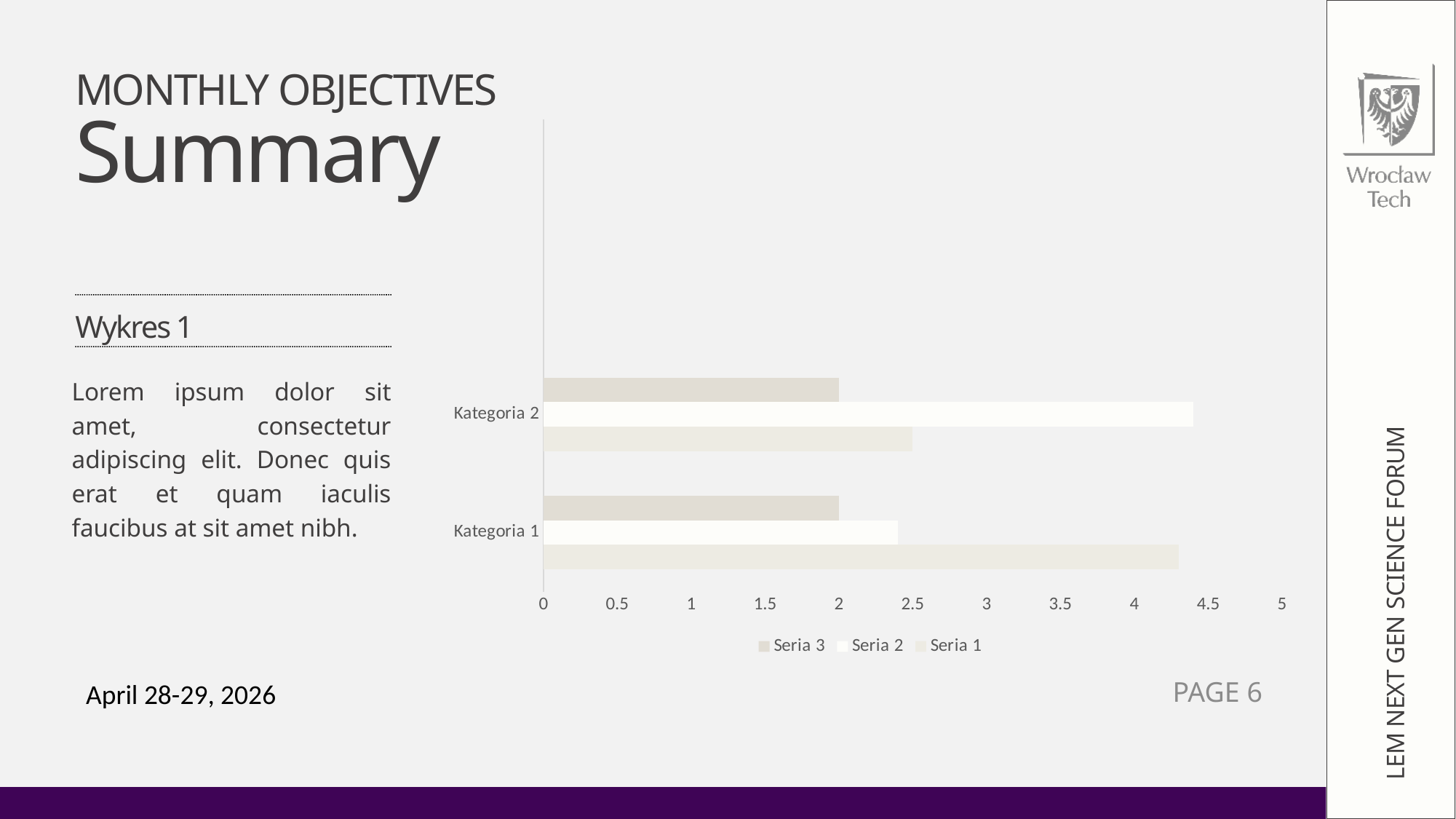
For Seria 1, which category has the larger value, Kategoria 1 or Kategoria 2? Kategoria 1 What is the value of Seria 3 for Kategoria 2? 2 How many series does the chart legend list? 3 How many categories are shown on the chart? 2 What is the value of Seria 3 for Kategoria 1? 2 What is the value of Seria 1 for Kategoria 2? 2.5 Is the value of Seria 2 for Kategoria 1 greater or less than 3? less Is the value of Seria 1 for Kategoria 1 greater or less than 4? greater Is the value of Seria 2 for Kategoria 2 greater or less than 4? greater What is the highest value shown on the horizontal axis? 5 What kind of chart is shown on the slide? bar chart Within Kategoria 2, which series has the highest value? Seria 2